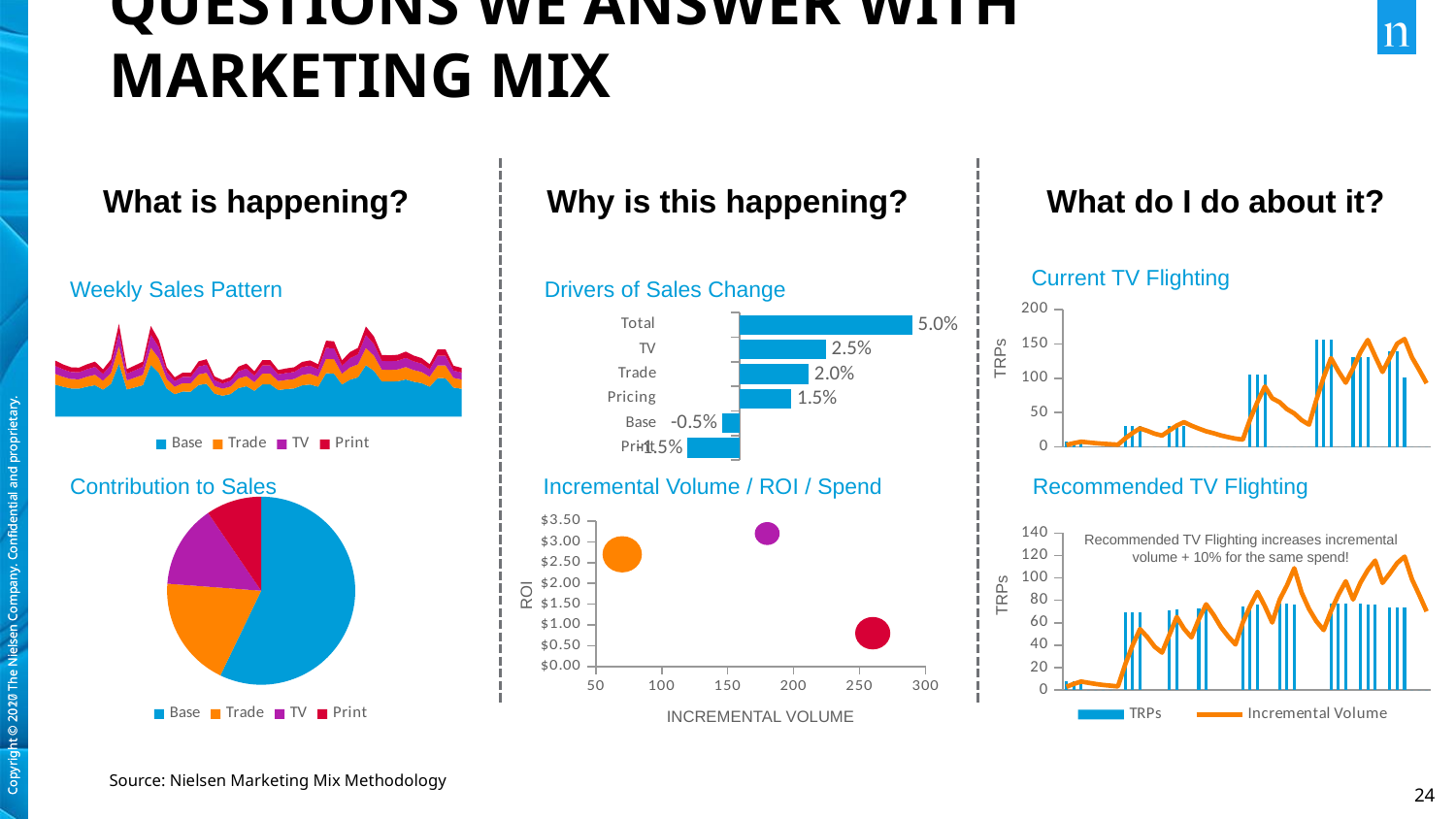
In the Drivers of Sales Change chart, what is the difference between the TV and Pricing values? 1.0% In the Drivers of Sales Change chart, which is larger, Trade or Pricing? Trade How many series does the legend of the Recommended TV Flighting chart list? 2 In the Drivers of Sales Change chart, what is the value for TV? 2.5% In the Drivers of Sales Change chart, what is the value for Total? 5.0% In the Contribution to Sales pie chart, which category has the smallest slice? Print In the Incremental Volume / ROI / Spend chart, is the ROI of the orange bubble greater or less than $2.00? greater In the Drivers of Sales Change chart, what is the value for Base? -0.5% What kind of chart is the Drivers of Sales Change chart? Bar chart How many series does the legend of the Weekly Sales Pattern chart list? 4 In the Drivers of Sales Change chart, which category has the lowest value? Print In the Contribution to Sales pie chart, which category has the largest slice? Base